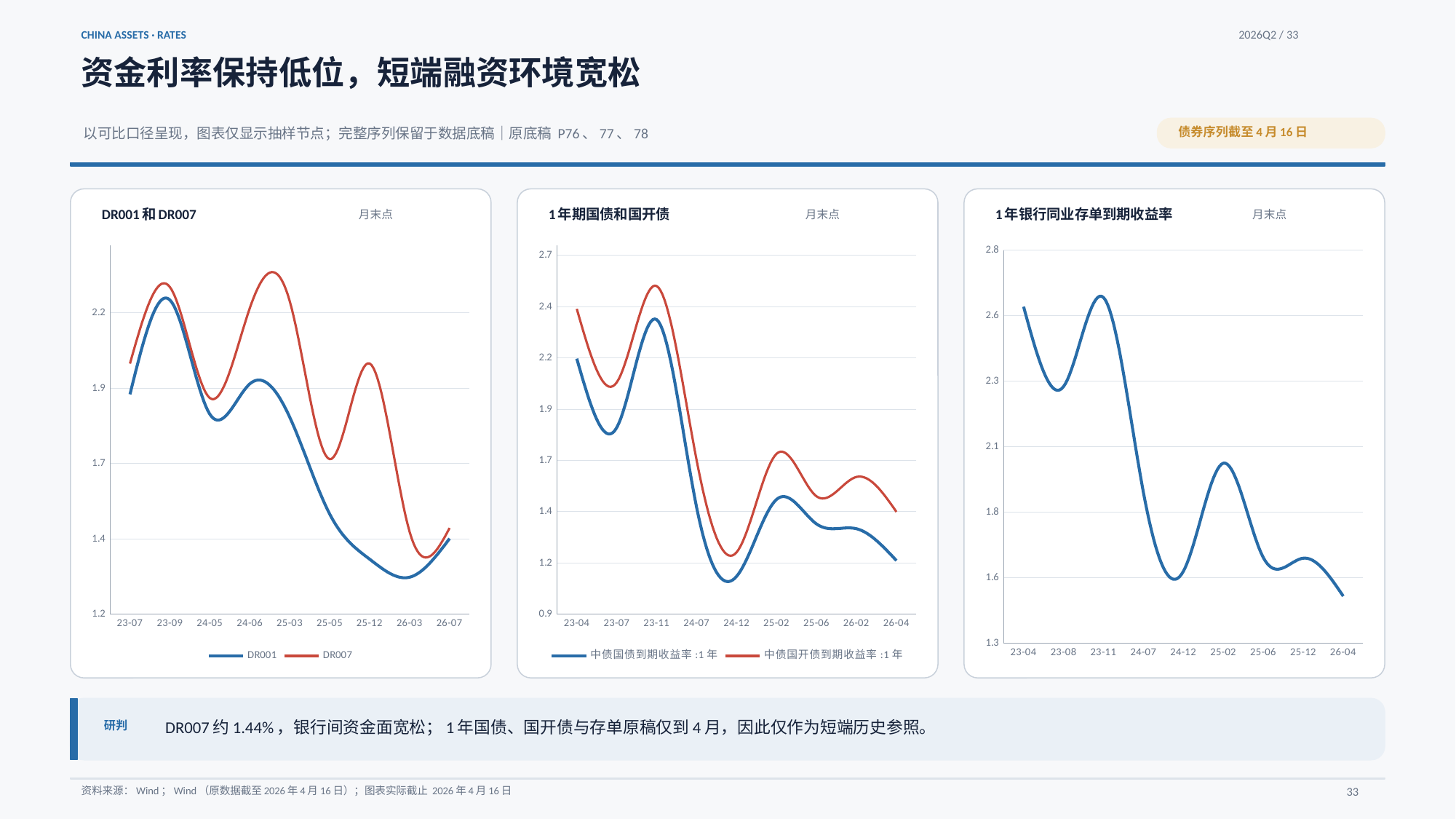
On the '1 年期国债和国开债' chart, is the value of 中债国债到期收益率:1 年 at 24-12 greater or less than 1.2? less On the '1 年期国债和国开债' chart, is the value of 中债国开债到期收益率:1 年 at 23-11 greater or less than 2.4? greater On the '1 年银行同业存单到期收益率' chart, do the values overall rise or fall from 23-04 to 26-04? fall How many series does the legend of the '1 年期国债和国开债' chart list? 2 On the 'DR001 和 DR007' chart, what colour is the DR007 line? red On the 'DR001 和 DR007' chart, is the value of DR001 at 26-03 greater or less than 1.4? less How many x-axis points are shown on the '1 年银行同业存单到期收益率' chart? 9 What kind of chart is the 'DR001 和 DR007' chart? line chart On the '1 年期国债和国开债' chart, which series has the larger value at 26-04? 中债国开债到期收益率:1 年 On the 'DR001 和 DR007' chart, which series has the larger value at 25-05, DR001 or DR007? DR007